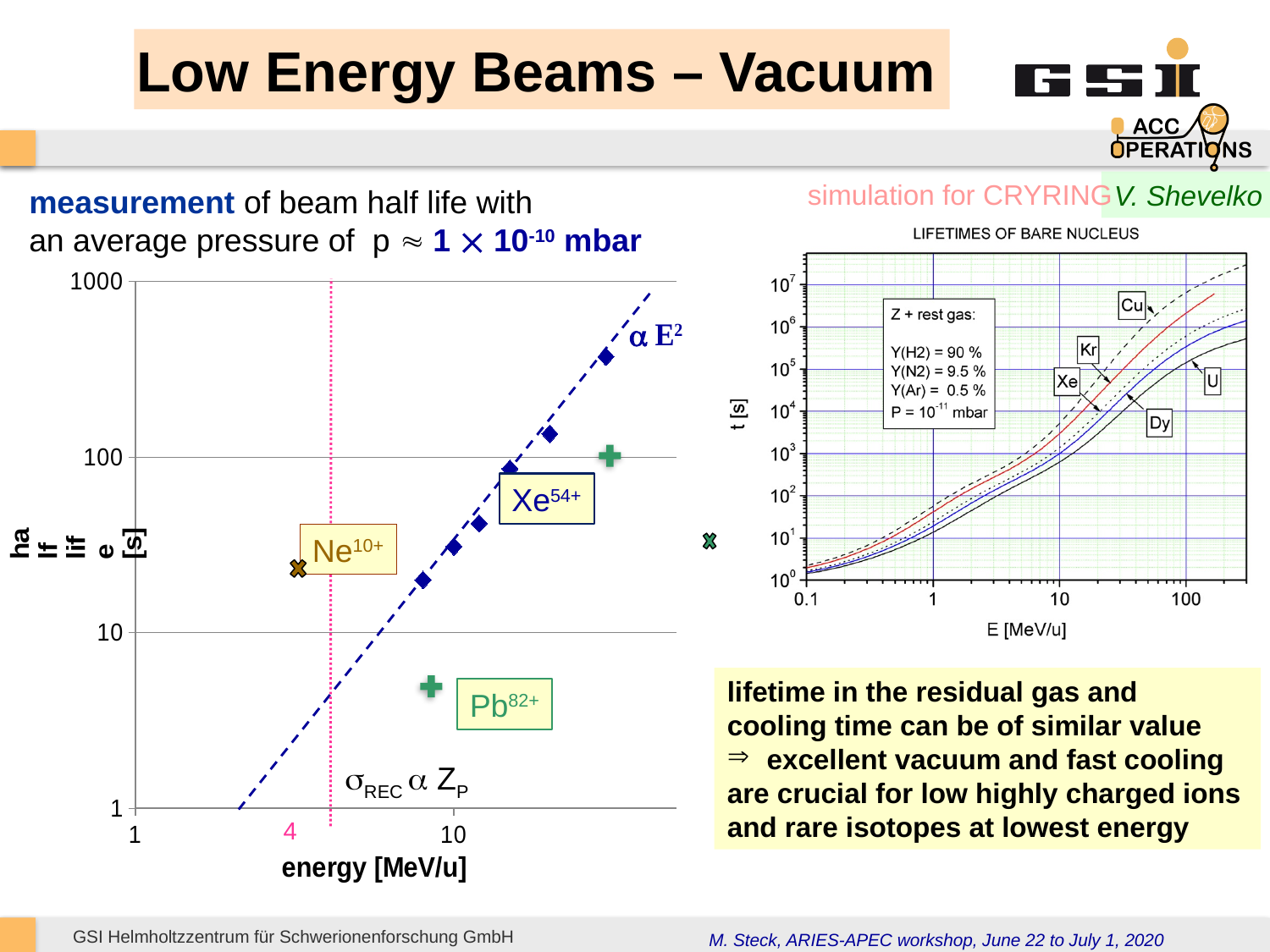
In the right chart, how many element curves are labelled? 5 In the left chart, which ion has the highest half life shown? Xe54+ What is the title of the right chart? LIFETIMES OF BARE NUCLEUS In the left chart, is the highest Xe54+ point greater or less than 100 s? greater In the left chart, how does the half life change as energy increases? it rises In the right chart, which element has the lowest lifetime curve? U In the left chart, is the half life of the lower Pb82+ point greater or less than 10 s? less In the left chart, is the half life for Ne10+ greater or less than 10 s? greater In the left chart, which has the larger half life: the Ne10+ point or the lower Pb82+ point? Ne10+ In the left chart, how many ion species are labelled? 3 What kind of chart is the left chart of beam half life versus energy? scatter chart